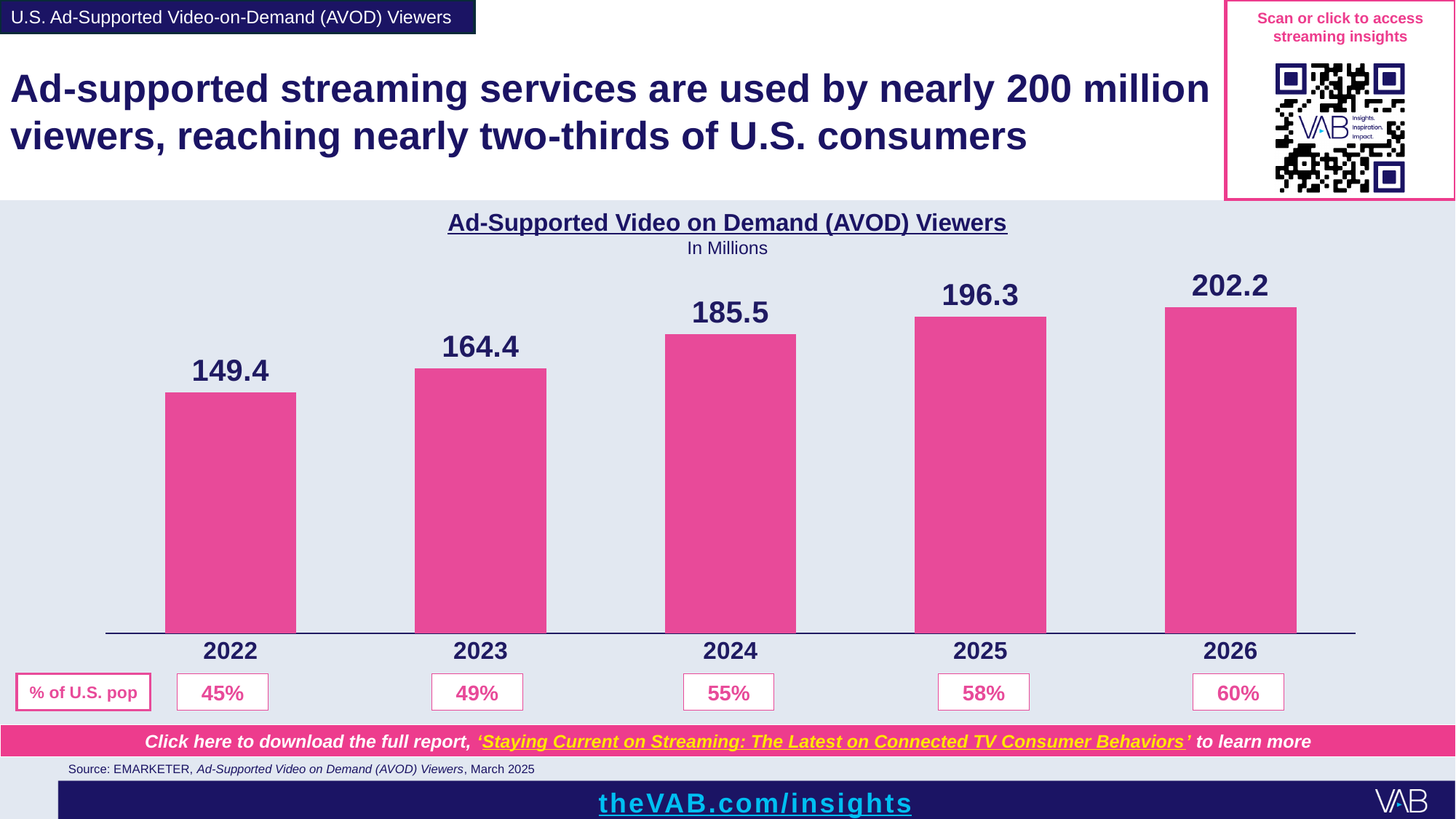
What percentage of the U.S. population do AVOD viewers represent in 2025? 58% What kind of chart is shown on the slide? Bar chart What is the number of AVOD viewers (in millions) for 2024? 185.5 What is the difference in AVOD viewers (in millions) between 2026 and 2022? 52.8 What is the number of AVOD viewers (in millions) for 2026? 202.2 What is the number of AVOD viewers (in millions) for 2022? 149.4 Which year has more AVOD viewers, 2023 or 2025? 2025 Which year has the highest number of AVOD viewers? 2026 Which year has the lowest number of AVOD viewers? 2022 What is the difference in AVOD viewers (in millions) between 2025 and 2024? 10.8 How many years are shown on the chart? 5 Do AVOD viewer numbers rise or fall from 2022 to 2026? Rise